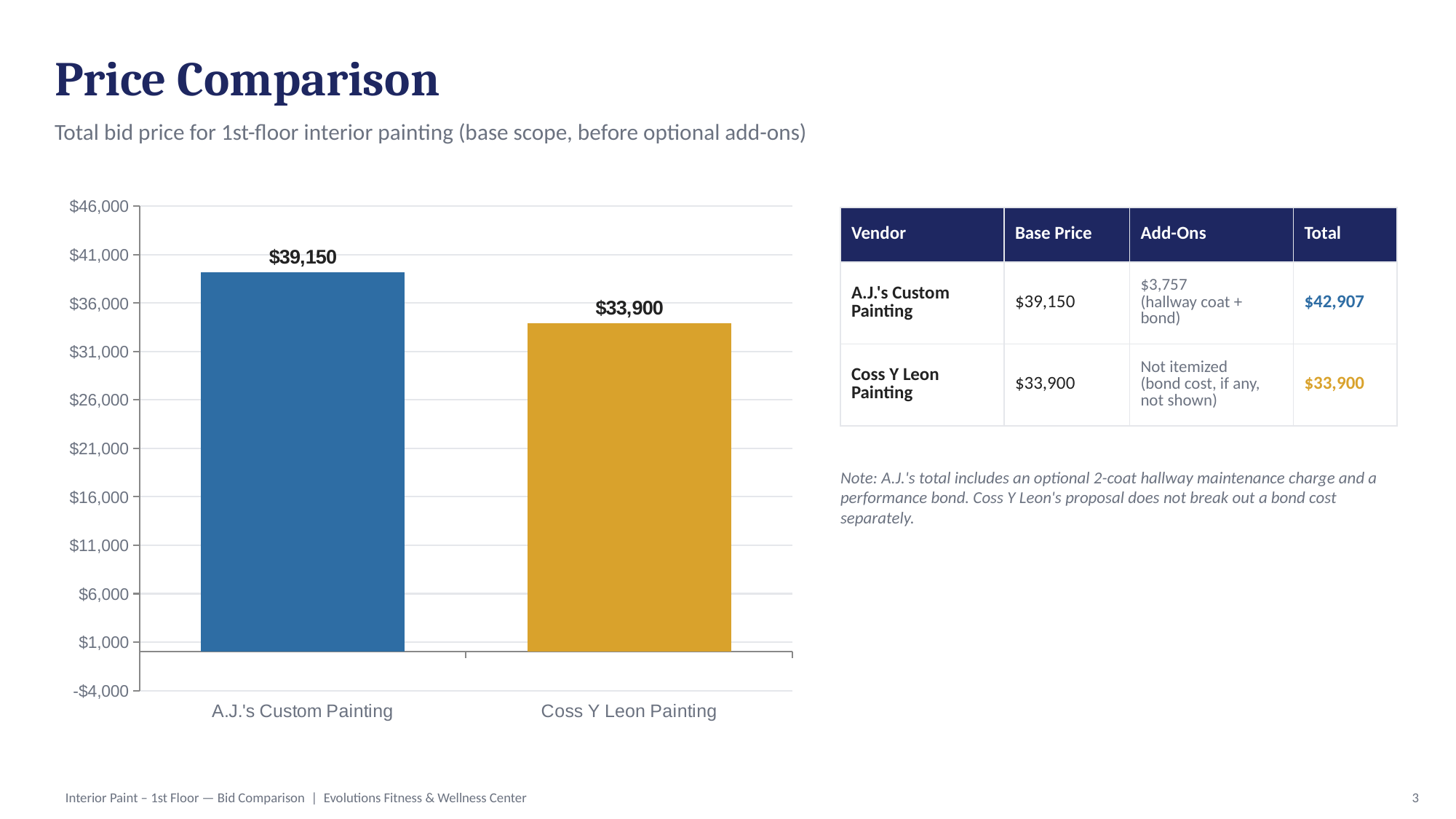
What is the bid price shown for Coss Y Leon Painting in the chart? $33,900 What is the difference between the bid prices of A.J.'s Custom Painting and Coss Y Leon Painting? $5,250 What is the bid price shown for A.J.'s Custom Painting in the chart? $39,150 What is the title of the slide containing the chart? Price Comparison Is the value for A.J.'s Custom Painting greater or less than $36,000? greater What colour is the bar for Coss Y Leon Painting? gold Which vendor has the lower bid price in the chart? Coss Y Leon Painting Is the bid price for Coss Y Leon Painting larger or smaller than that for A.J.'s Custom Painting? smaller What kind of chart is shown on the slide? bar chart Which vendor has the higher bid price in the chart? A.J.'s Custom Painting Is the value for Coss Y Leon Painting greater or less than $36,000? less How many vendors are plotted in the chart? 2